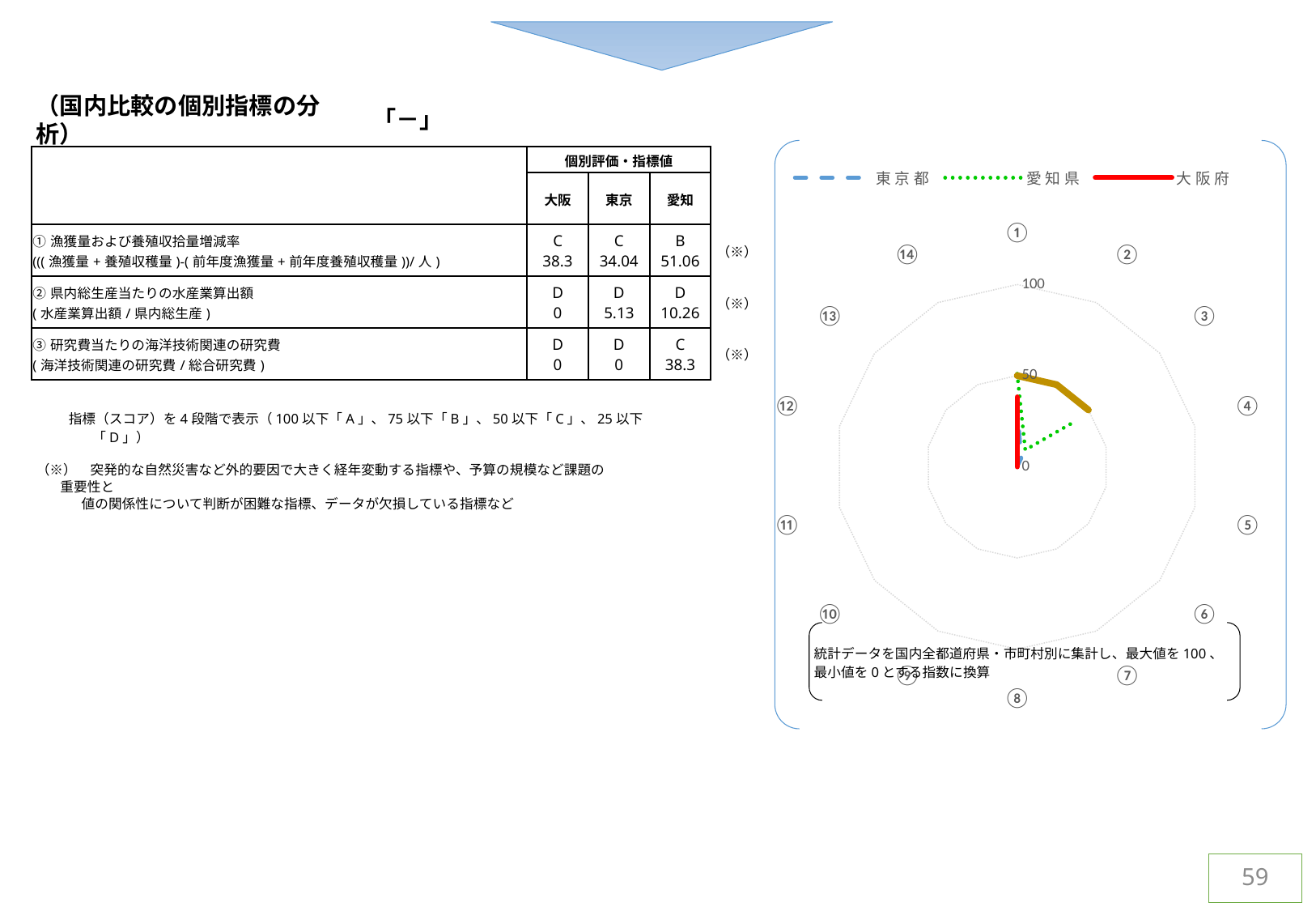
What kind of chart is shown on the right side of the slide? radar chart What is the maximum value shown on the radar chart's scale? 100 On the radar chart, is the value for 大阪府 on indicator ① greater or less than 50? less On the radar chart, is the value for 愛知県 on indicator ② greater or less than 50? less On the radar chart, is the value for 東京都 on indicator ③ greater or less than 50? less How many numbered axes (indicators) does the radar chart have? 14 Which three series are listed in the legend of the radar chart? 東京都, 愛知県, 大阪府 How many series does the legend of the radar chart list? 3